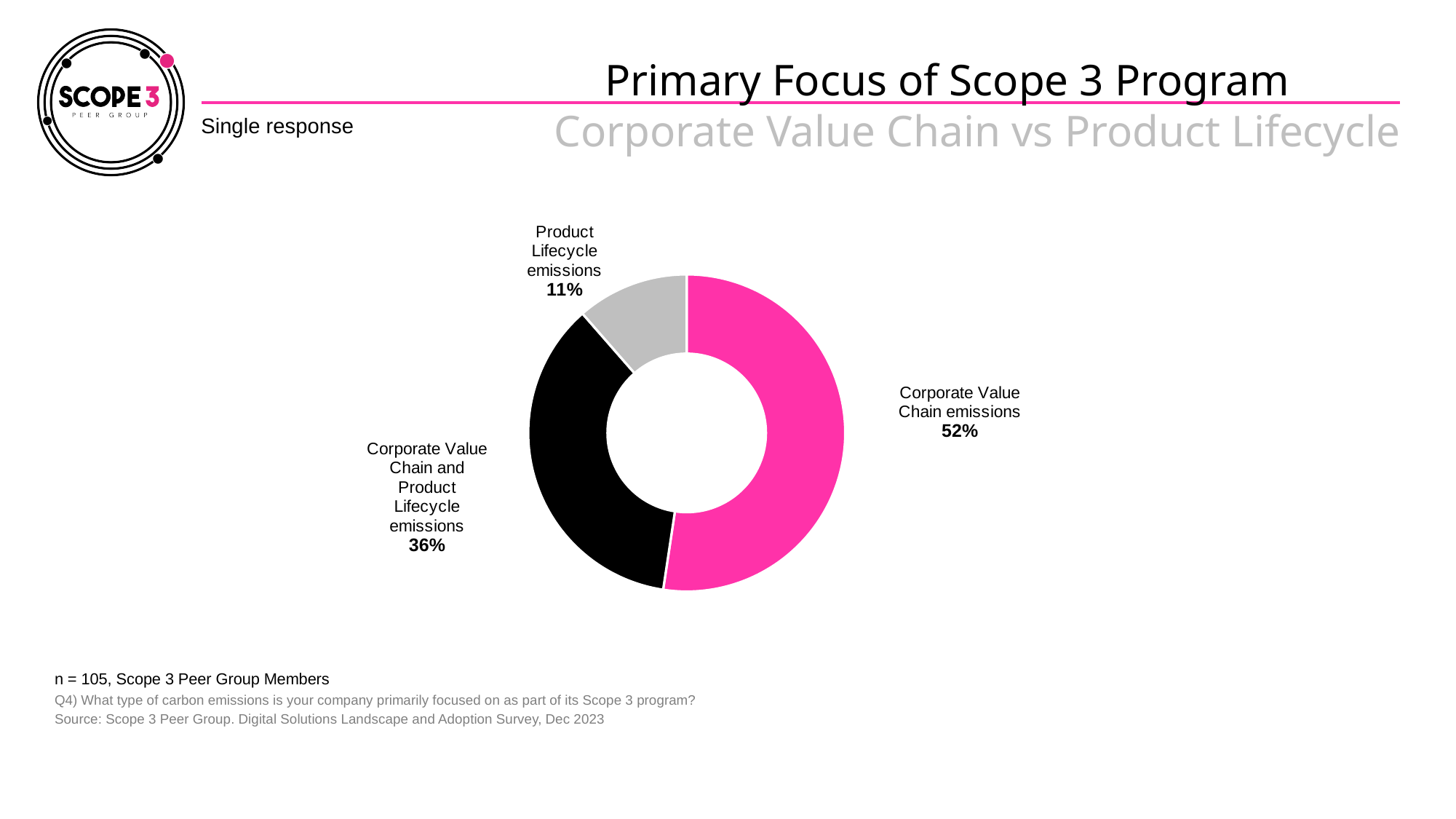
What percentage of respondents are focused on both Corporate Value Chain and Product Lifecycle emissions? 36% Which category has the largest share of the chart? Corporate Value Chain emissions What percentage of respondents are primarily focused on Product Lifecycle emissions? 11% Which category has the smallest share of the chart? Product Lifecycle emissions Which is larger: the share for Corporate Value Chain and Product Lifecycle emissions or the share for Product Lifecycle emissions? Corporate Value Chain and Product Lifecycle emissions What is the difference in percentage points between Corporate Value Chain emissions and Corporate Value Chain and Product Lifecycle emissions? 16 percentage points What percentage of respondents are primarily focused on Corporate Value Chain emissions? 52% What kind of chart is shown on the slide? Doughnut (pie) chart What colour is the slice for Corporate Value Chain emissions? Pink How many categories are shown in the chart? 3 What is the difference in percentage points between Corporate Value Chain emissions and Product Lifecycle emissions? 41 percentage points What is the sample size (n) stated on the slide? 105